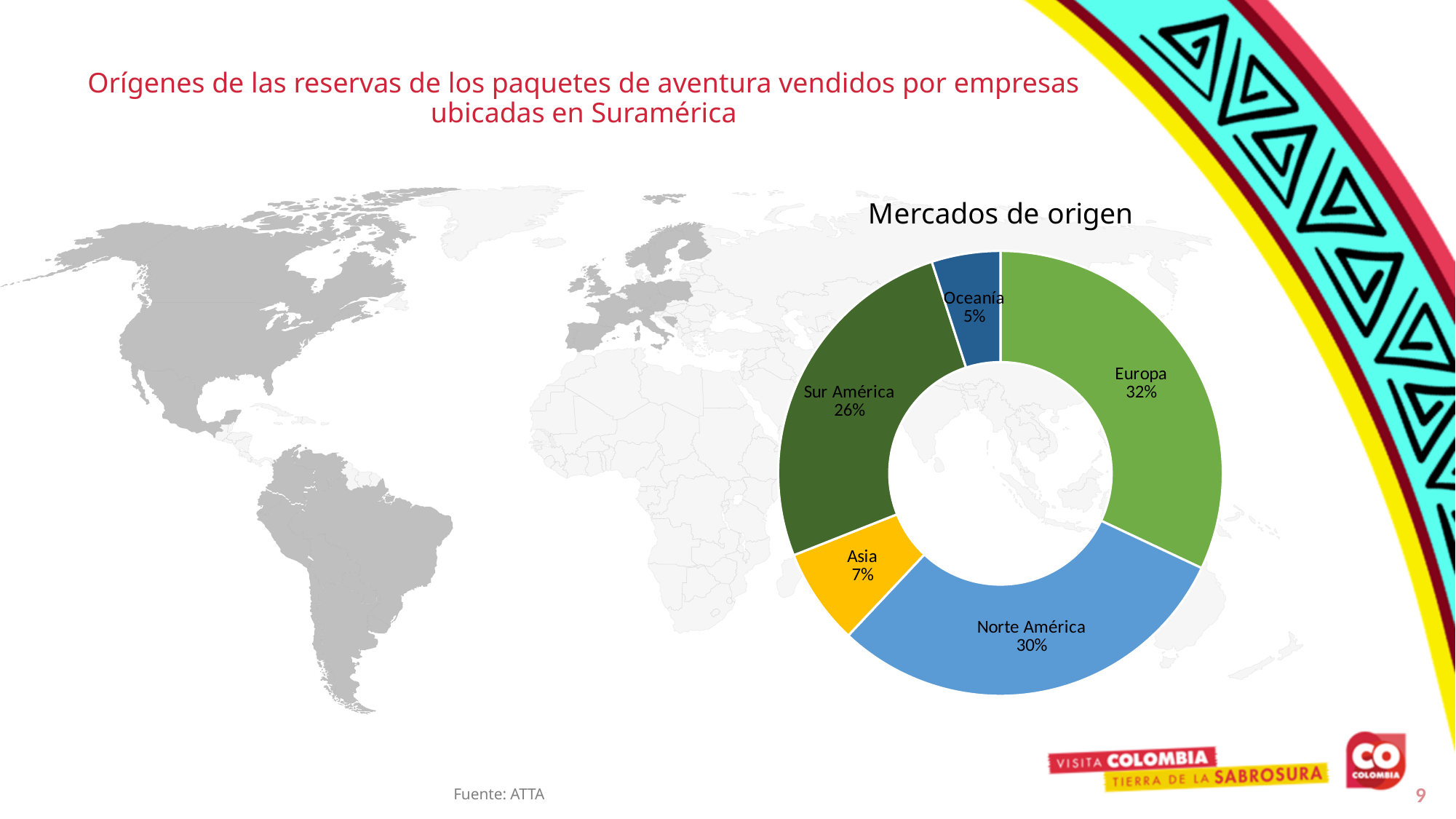
Which market has the largest share in the Mercados de origen chart? Europa Which market has the smallest share in the Mercados de origen chart? Oceanía What share does Oceanía have in the Mercados de origen chart? 5% How many markets are shown in the Mercados de origen chart? 5 What share does Europa have in the Mercados de origen chart? 32% Which has a larger share in the Mercados de origen chart, Asia or Oceanía? Asia What is the difference in percentage points between Europa and Sur América in the Mercados de origen chart? 6 What share does Norte América have in the Mercados de origen chart? 30% What is the title of the chart on the slide? Mercados de origen What kind of chart is the Mercados de origen chart? Doughnut (pie) chart What share does Asia have in the Mercados de origen chart? 7% What share does Sur América have in the Mercados de origen chart? 26%